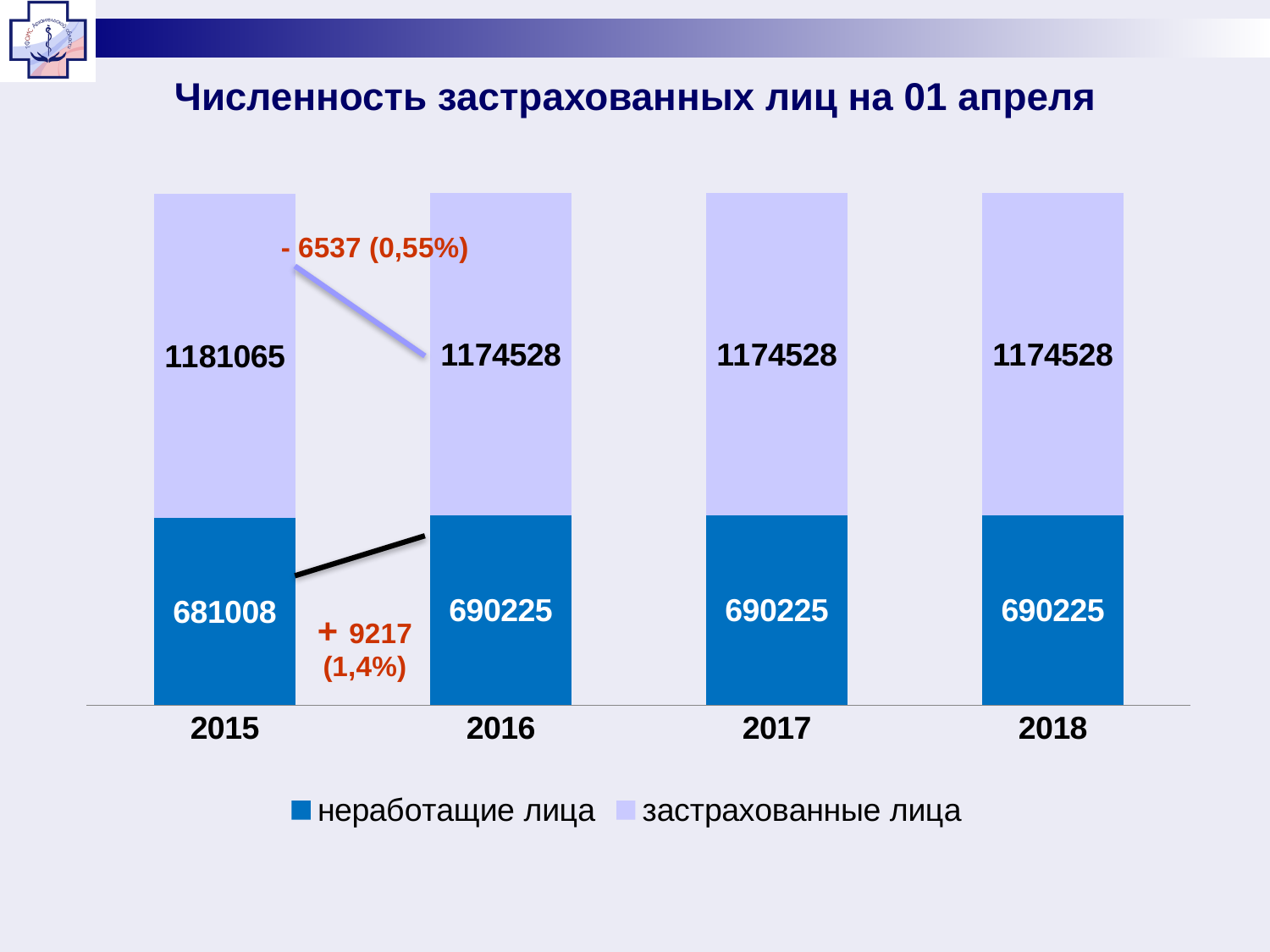
In which year is the value for застрахованные лица the highest? 2015 By how much does the value for неработащие лица in 2016 exceed the value in 2015? 9217 What is the title of the chart? Численность застрахованных лиц на 01 апреля What is the value for застрахованные лица in 2016? 1174528 Which year has the larger value for неработащие лица, 2015 or 2016? 2016 What is the difference between the застрахованные лица values for 2015 and 2016? 6537 What kind of chart is shown on the slide? Stacked bar chart How many series does the legend list? 2 What is the value for неработащие лица in 2018? 690225 How many years are shown on the x axis? 4 What is the value for неработащие лица in 2015? 681008 In which year is the value for неработащие лица the lowest? 2015